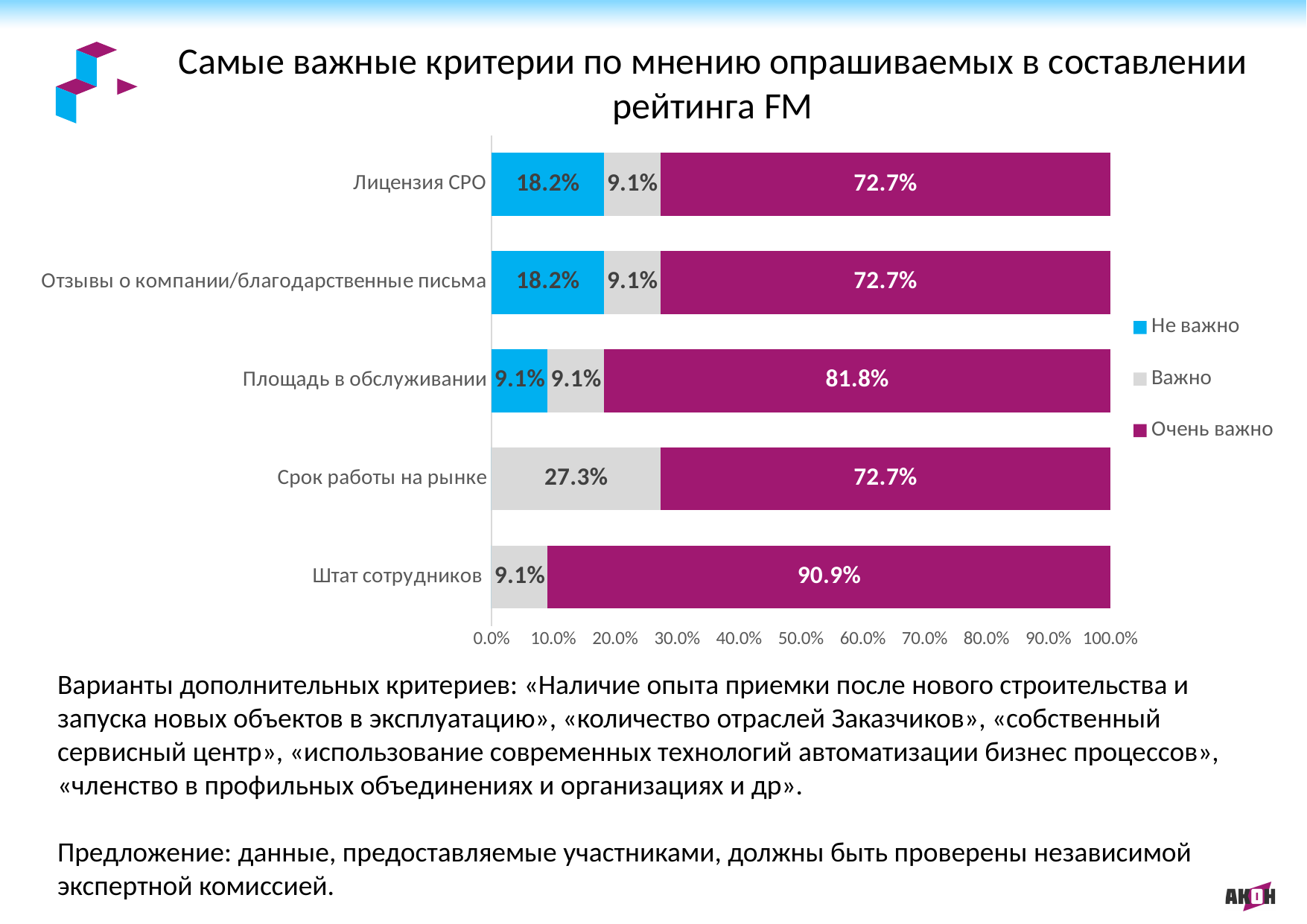
Which criterion has the highest «Очень важно» share? Штат сотрудников What share of respondents rated «Штат сотрудников» as «Очень важно»? 90.9% What is the «Очень важно» value for «Площадь в обслуживании»? 81.8% What is the «Не важно» value for «Лицензия СРО»? 18.2% What is the difference between the «Очень важно» values for «Штат сотрудников» and «Площадь в обслуживании»? 9.1% Which is larger: the «Не важно» value for «Лицензия СРО» or for «Площадь в обслуживании»? Лицензия СРО How many series does the legend list? 3 Which colour represents the «Очень важно» series in the legend? Magenta (purple) What type of chart is shown on the slide? Stacked bar chart What is the «Важно» value for «Срок работы на рынке»? 27.3% Which criterion has the highest «Важно» share? Срок работы на рынке How many criteria (categories) are shown in the chart? 5